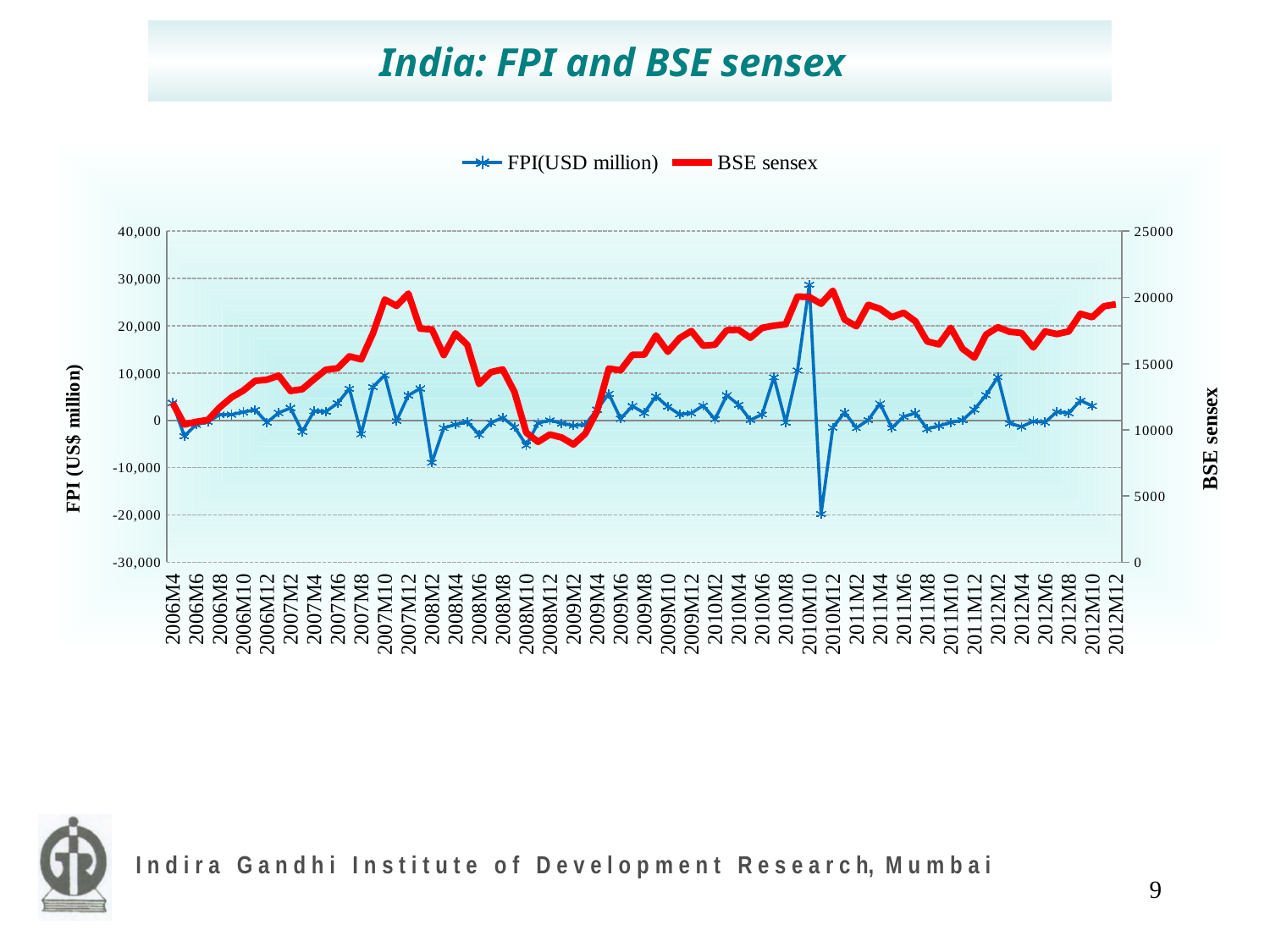
How many series does the legend list? 2 What kind of chart is shown on the slide? line chart Is the BSE sensex value for 2006M6 greater or less than 15000? less Does the BSE sensex series rise or fall between 2006M4 and 2007M12? rise Which series is plotted against the right-hand axis labelled BSE sensex? BSE sensex Is the FPI (USD million) value for 2010M11 greater or less than -10,000? less Is the FPI (USD million) value for 2010M10 greater or less than 20,000? greater What is the title of the chart? India: FPI and BSE sensex In which month does the FPI (USD million) series reach its lowest value? 2010M11 Which is larger, the BSE sensex value for 2007M12 or for 2009M2? 2007M12 In which month does the FPI (USD million) series reach its highest value? 2010M10